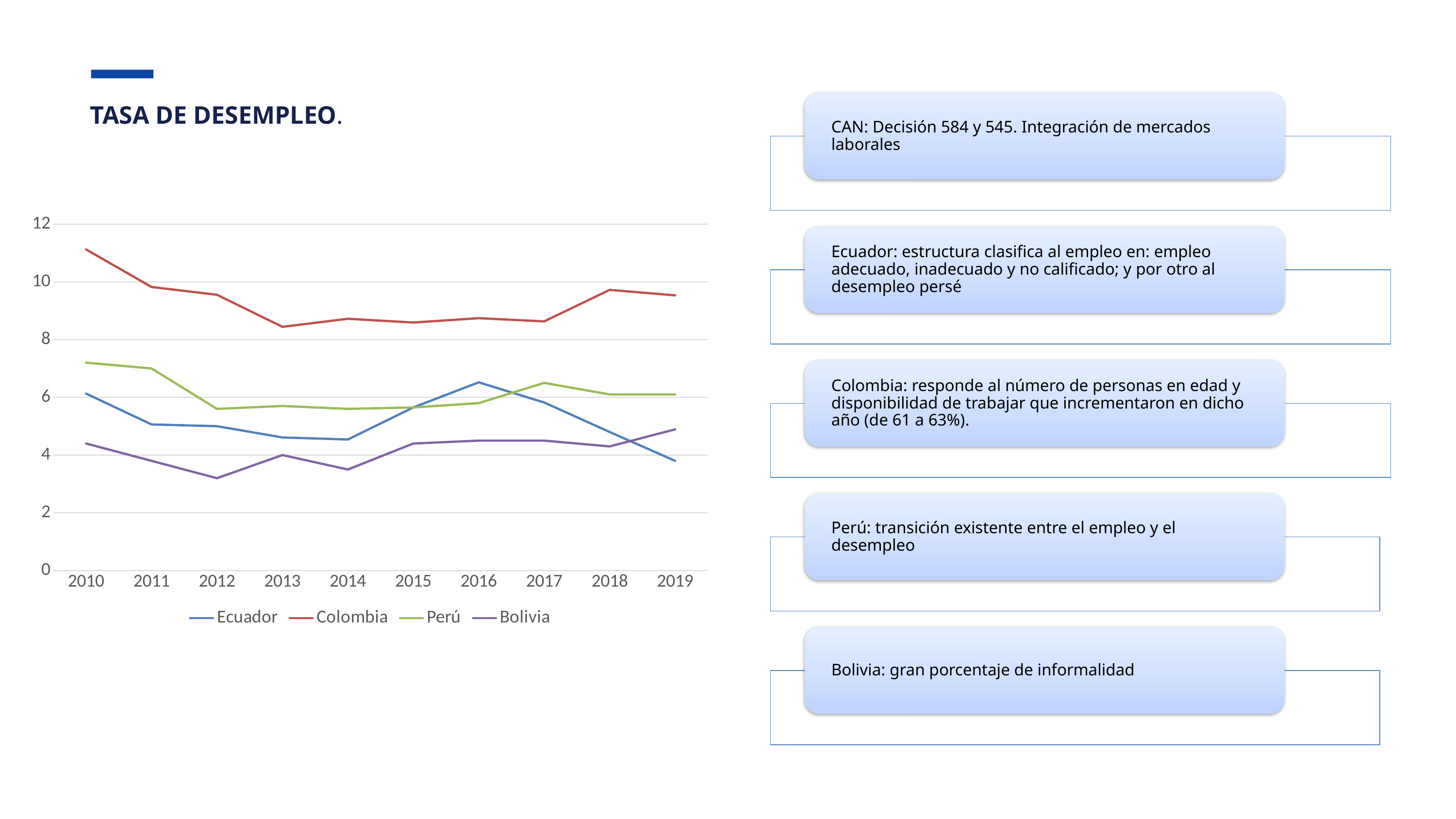
What is the title of the chart? TASA DE DESEMPLEO. How many years are shown on the x axis? 10 How many series does the legend list? 4 Is the value for Bolivia in 2012 greater or less than 4? less What kind of chart is shown on the slide? Line chart In 2016, which is higher: Ecuador or Perú? Ecuador Is the value for Colombia in 2010 greater or less than 10? greater Is the value for Perú in 2010 greater or less than 6? greater In which year does Colombia reach its highest value? 2010 Does the Ecuador line rise or fall from 2016 to 2019? Fall Which country has the highest unemployment rate in 2010? Colombia Which country has the lowest unemployment rate in 2012? Bolivia